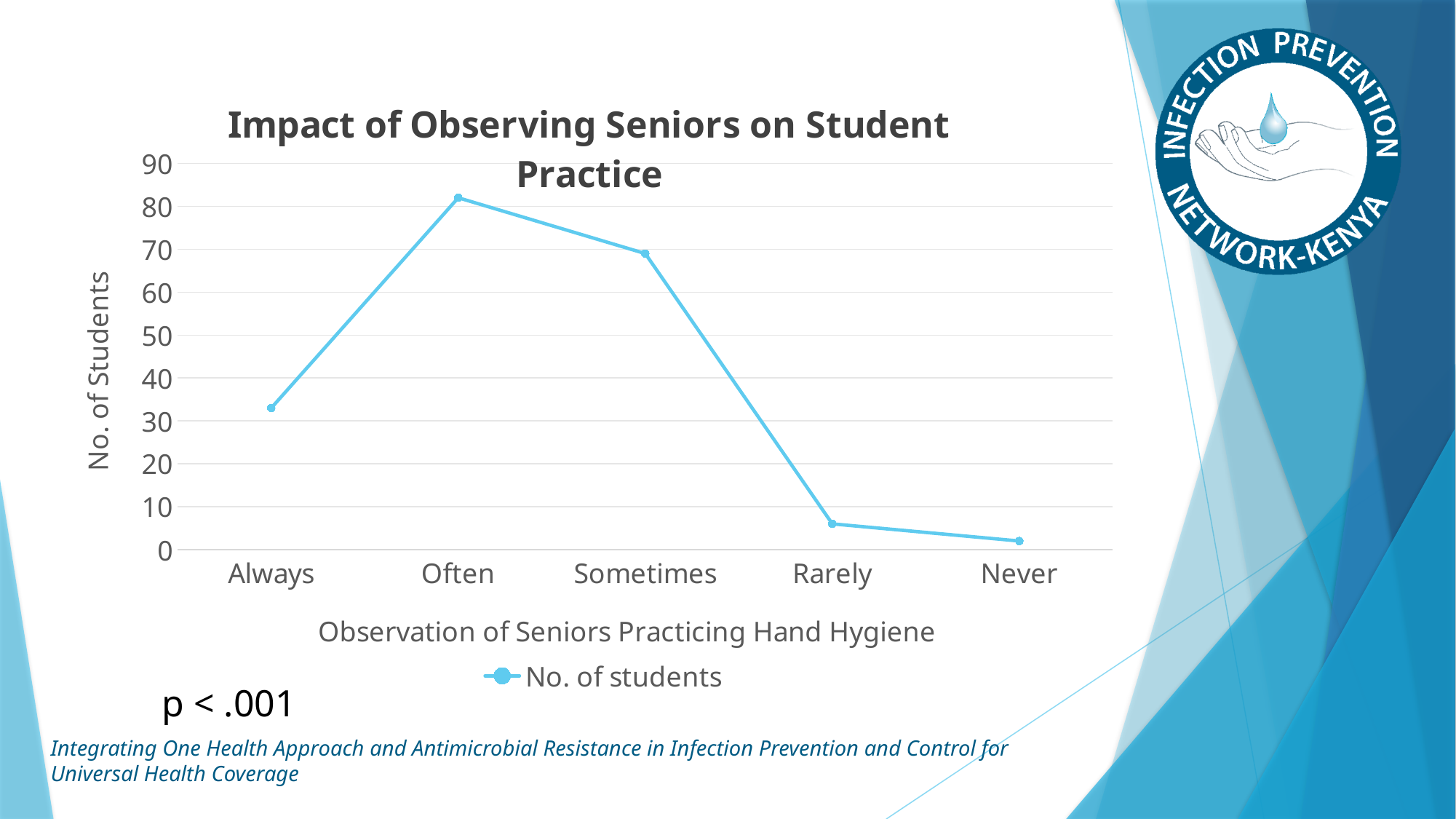
Which category has the lowest number of students? Never Is the value for Always greater or less than 40? less What is the title of the chart? Impact of Observing Seniors on Student Practice Do the values rise or fall from Often to Never? fall Which category has the highest number of students? Often Is the value for Sometimes greater or less than 60? greater Which has more students, Often or Sometimes? Often What kind of chart is shown on the slide? line chart How many series does the legend list? 1 Is the value for Rarely greater or less than 10? less How many categories are shown on the x axis? 5